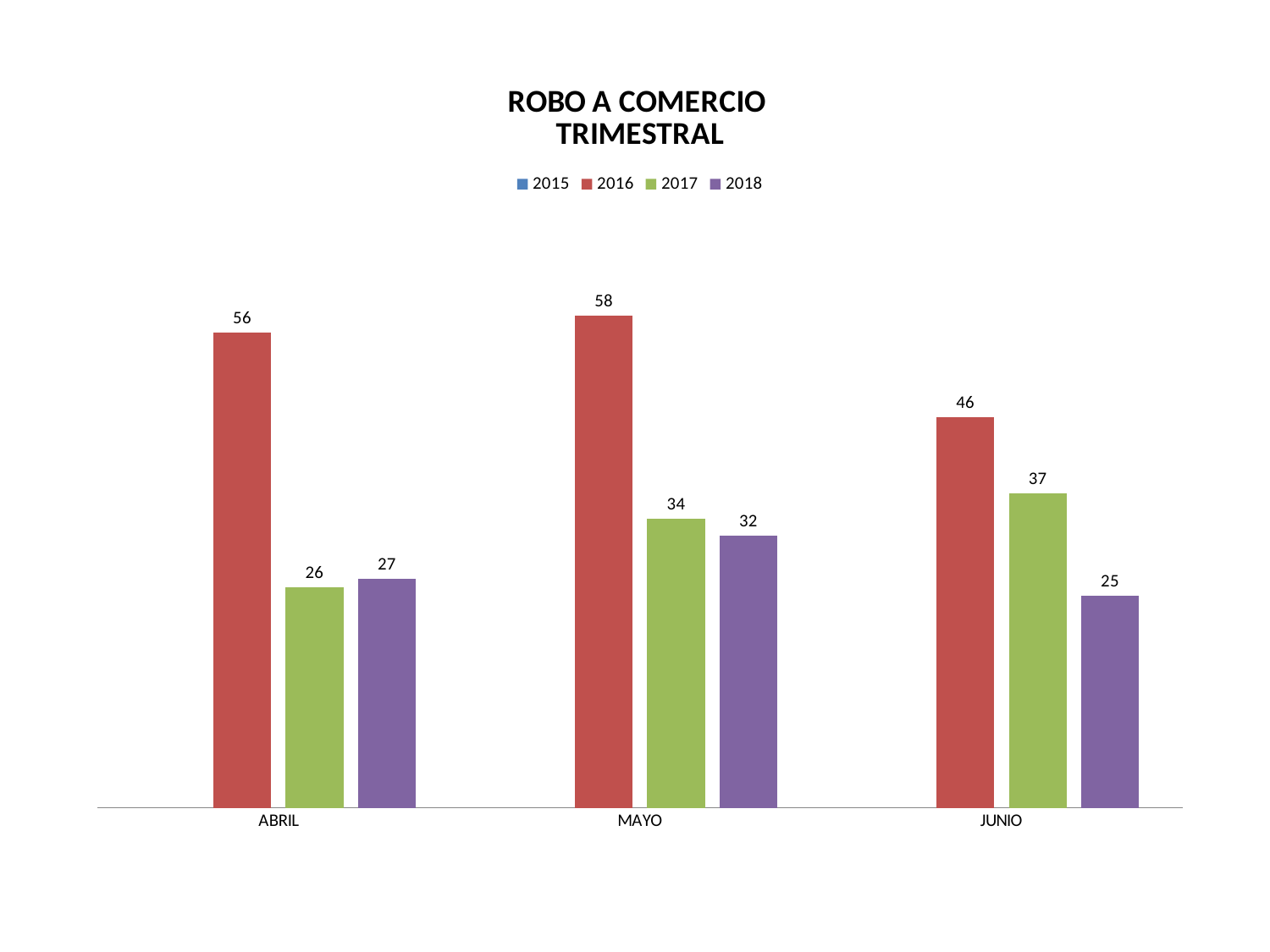
What is the difference between the 2016 and 2017 values in ABRIL? 30 What is the value for 2018 in JUNIO? 25 Which is larger in MAYO, the value for 2017 or the value for 2018? 2017 Which month has the highest value for 2016? MAYO What is the title of the chart? ROBO A COMERCIO TRIMESTRAL What is the difference between the 2017 values in JUNIO and MAYO? 3 How many series does the legend list? 4 What kind of chart is shown on the slide? bar chart Which month has the lowest value for 2018? JUNIO What is the value for 2016 in MAYO? 58 What is the value for 2017 in ABRIL? 26 How many months are shown on the x axis? 3